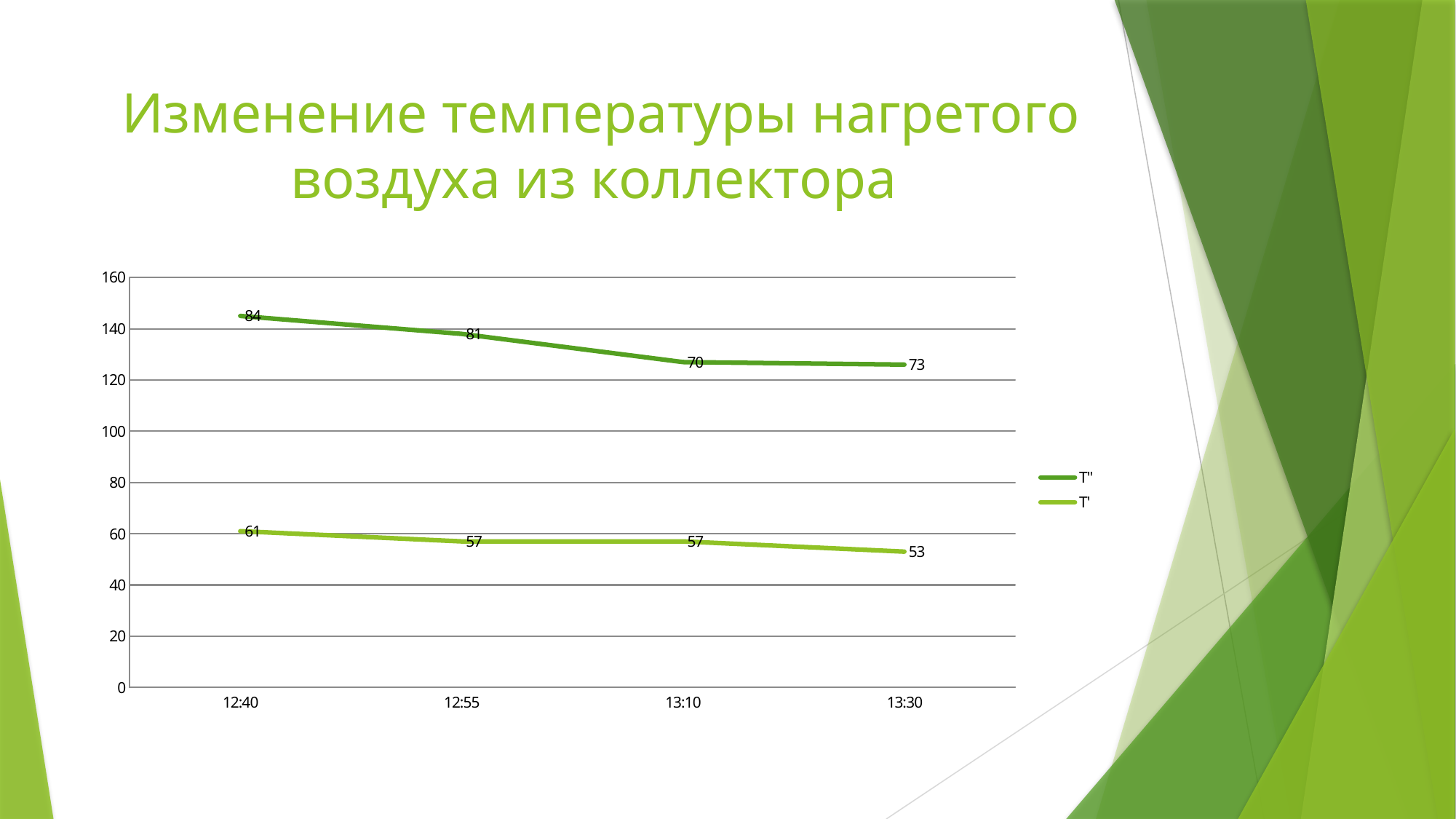
What is the value of T'' at 13:10? 70 What is the value of T'' at 12:40? 84 Which is larger at 13:30, T'' or T'? T'' What is the difference between T'' and T' at 12:40? 23 At which time is T'' highest? 12:40 How many series does the legend list? 2 What is the value of T' at 13:30? 53 At which time is T' lowest? 13:30 How many time points are plotted along the x axis? 4 What type of chart is shown on the slide? line chart What is the value of T' at 12:55? 57 Does T' rise or fall from 12:40 to 13:30? fall